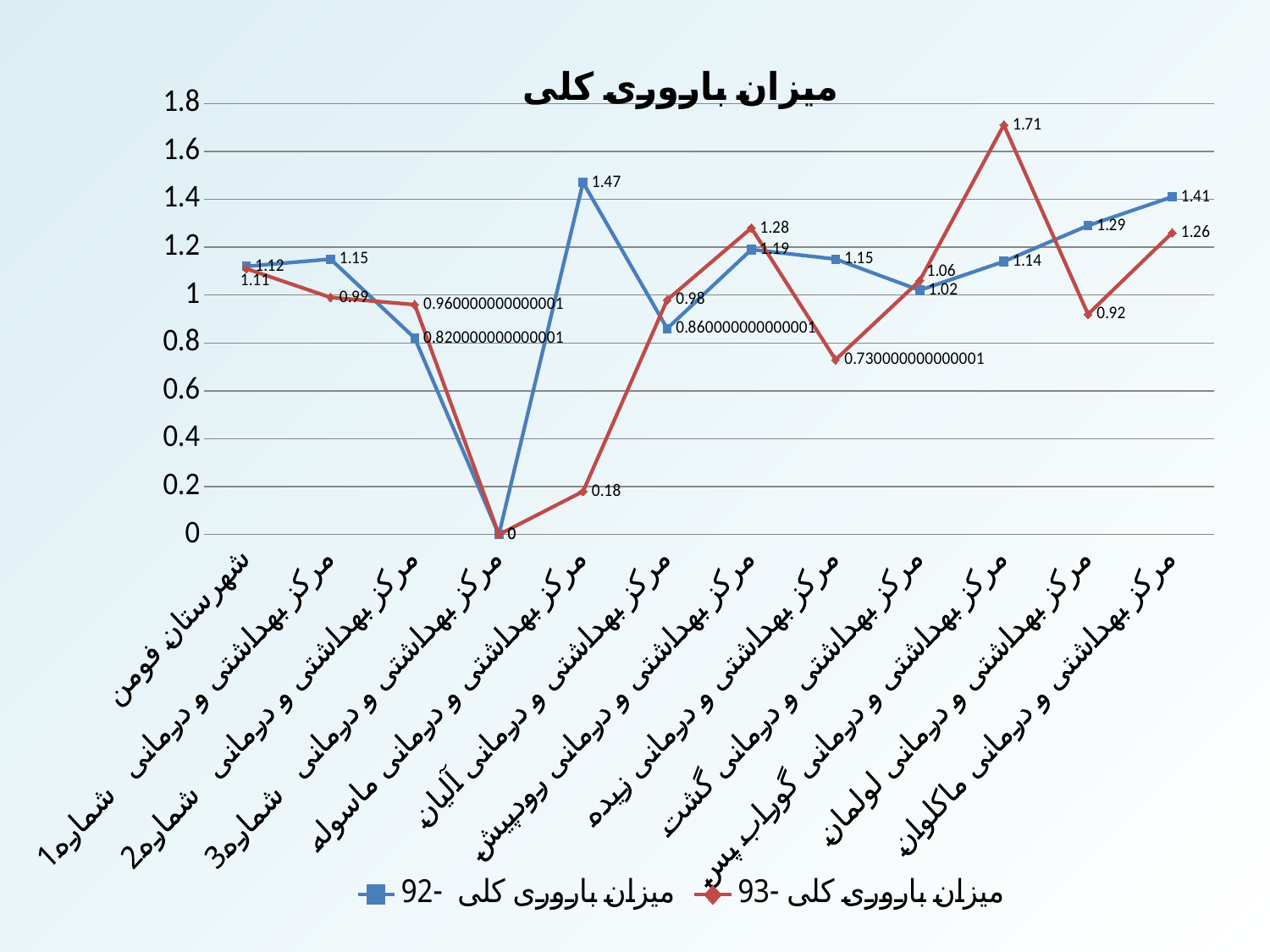
What kind of chart is shown on the slide? line chart What is the value of the 'میزان باروری کلی -93' series for 'مرکز بهداشتی و درمانی ماسوله'? 0.18 What is the difference between the 'میزان باروری کلی -93' and 'میزان باروری کلی -92' values for 'مرکز بهداشتی و درمانی گوراب پس'? 0.57 For 'مرکز بهداشتی و درمانی لولمان', which series has the larger value, 'میزان باروری کلی -92' or 'میزان باروری کلی -93'? میزان باروری کلی -92 How many categories are plotted along the x axis? 12 Which category has the highest value in the 'میزان باروری کلی -93' series? مرکز بهداشتی و درمانی گوراب پس Which category has the highest value in the 'میزان باروری کلی -92' series? مرکز بهداشتی و درمانی ماسوله Which category has the lowest value in both series? مرکز بهداشتی و درمانی شماره3 What is the value of the 'میزان باروری کلی -92' series for 'مرکز بهداشتی و درمانی ماسوله'? 1.47 What is the value of the 'میزان باروری کلی -93' series for 'مرکز بهداشتی و درمانی گوراب پس'? 1.71 What is the title of the chart? میزان باروری کلی How many series does the legend list? 2